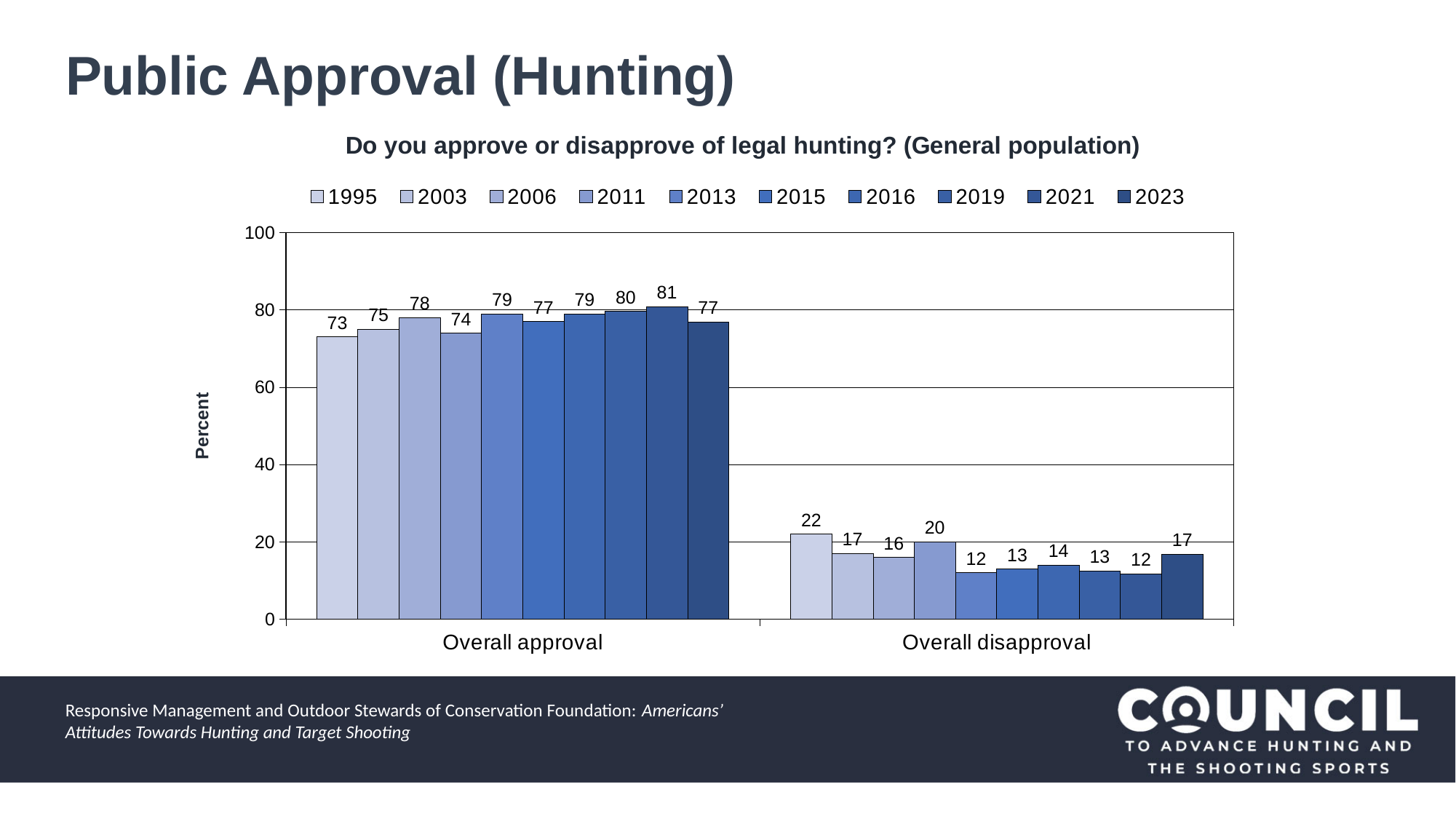
What is the difference between the Overall approval values for 2021 and 1995? 8 Which is larger, the Overall disapproval value for 2011 or for 2023? 2011 What is the Overall approval value for 2021? 81 What is the Overall approval value for 2023? 77 How many categories are shown on the x axis? 2 Which year has the lowest Overall approval value? 1995 How many series does the legend list? 10 What kind of chart is shown on the slide? bar chart Which year has the highest Overall disapproval value? 1995 What is the Overall disapproval value for 1995? 22 Which year has the highest Overall approval value? 2021 What is the title of the chart? Do you approve or disapprove of legal hunting? (General population)